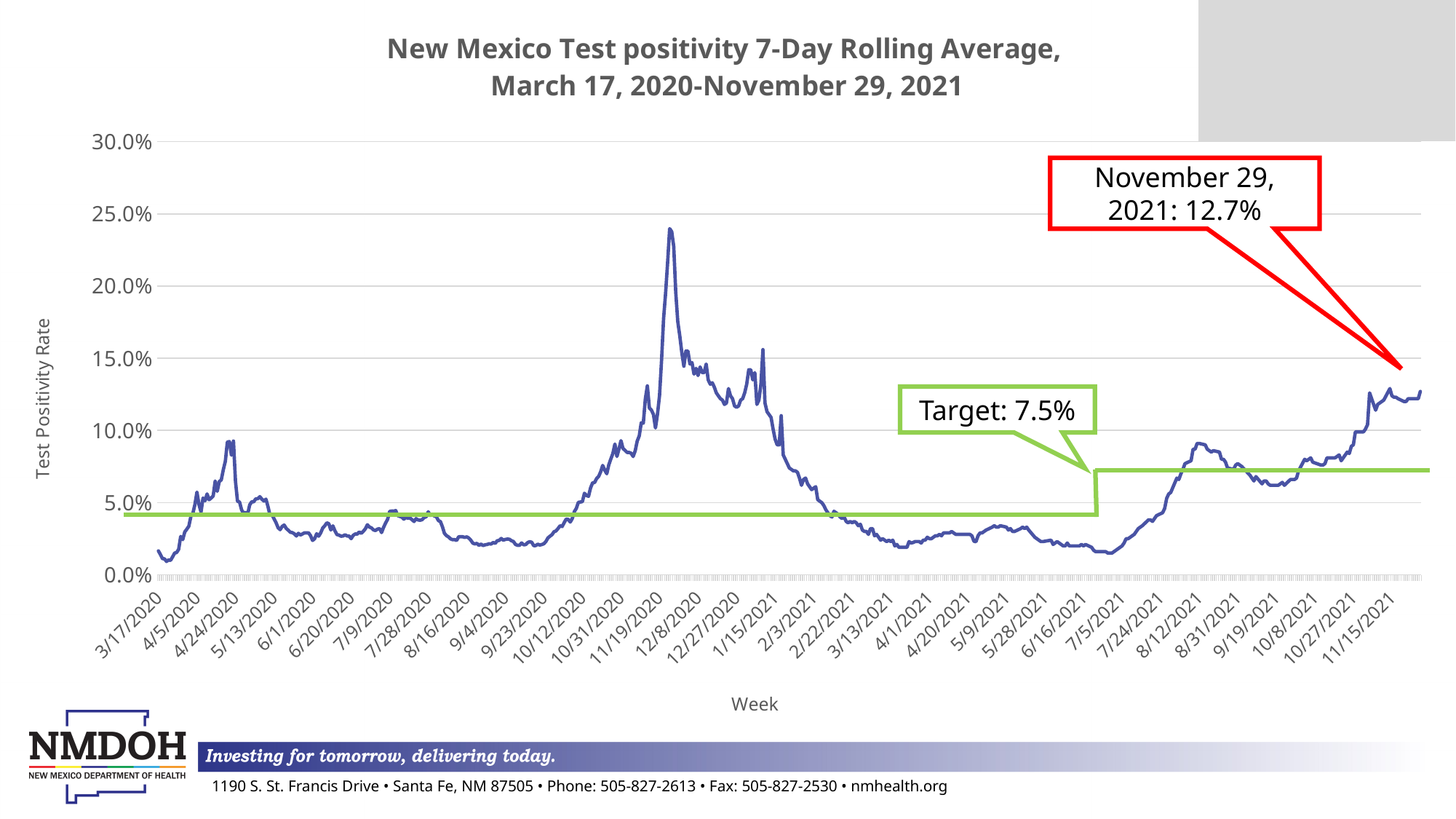
Between 7/5/2021 and 11/15/2021, does the test positivity rate generally rise or fall? rise Is the value at the start of the series, 3/17/2020, greater or less than 5.0%? less What is the label of the y-axis? Test Positivity Rate Which is larger, the November 29, 2021 value or the target? November 29, 2021 value Is the highest peak of the line, near 11/19/2020, greater or less than 20.0%? greater What is the label of the x-axis? Week What was the New Mexico test positivity 7-day rolling average on November 29, 2021? 12.7% Near which x-axis label does the line reach its highest peak? 11/19/2020 By how many percentage points does the November 29, 2021 value exceed the target of 7.5%? 5.2 percentage points What target value is marked on the chart? 7.5% Is the value around 4/1/2021 greater or less than 5.0%? less What kind of chart is shown on the slide? line chart